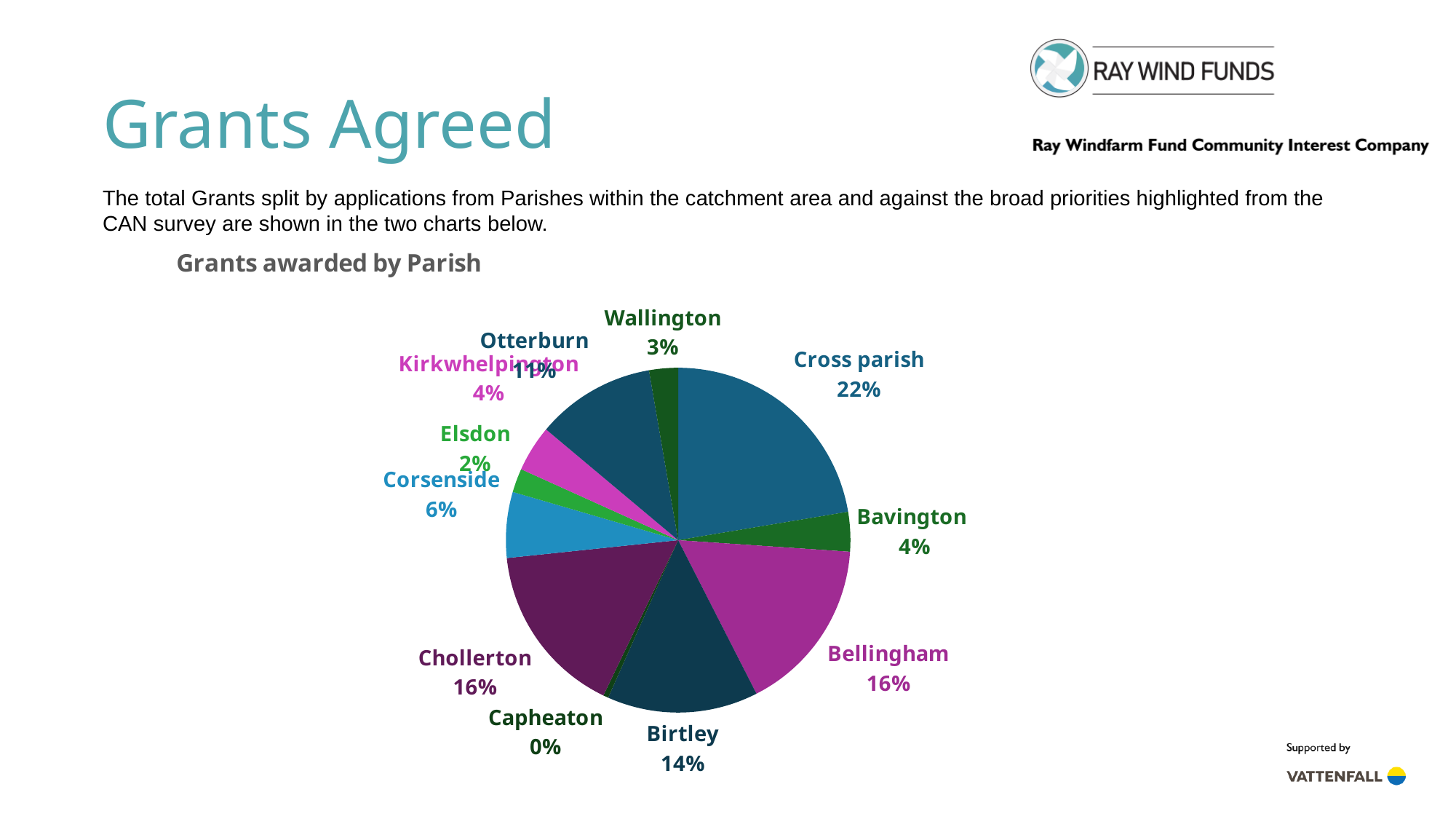
What is the title of the chart? Grants awarded by Parish How many parishes are shown in the pie chart? 11 What percentage of grants went to Wallington? 3% What is the difference between the shares for Cross parish and Birtley? 8% Which received a larger share of grants, Corsenside or Bavington? Corsenside What percentage of grants went to Corsenside? 6% What is the combined share of Bellingham and Chollerton? 32% Which parish received the smallest share of grants? Capheaton What share of grants was awarded to Cross parish? 22% Which parish received the largest share of grants? Cross parish What type of chart is shown on the slide? pie chart What percentage of grants went to Birtley? 14%